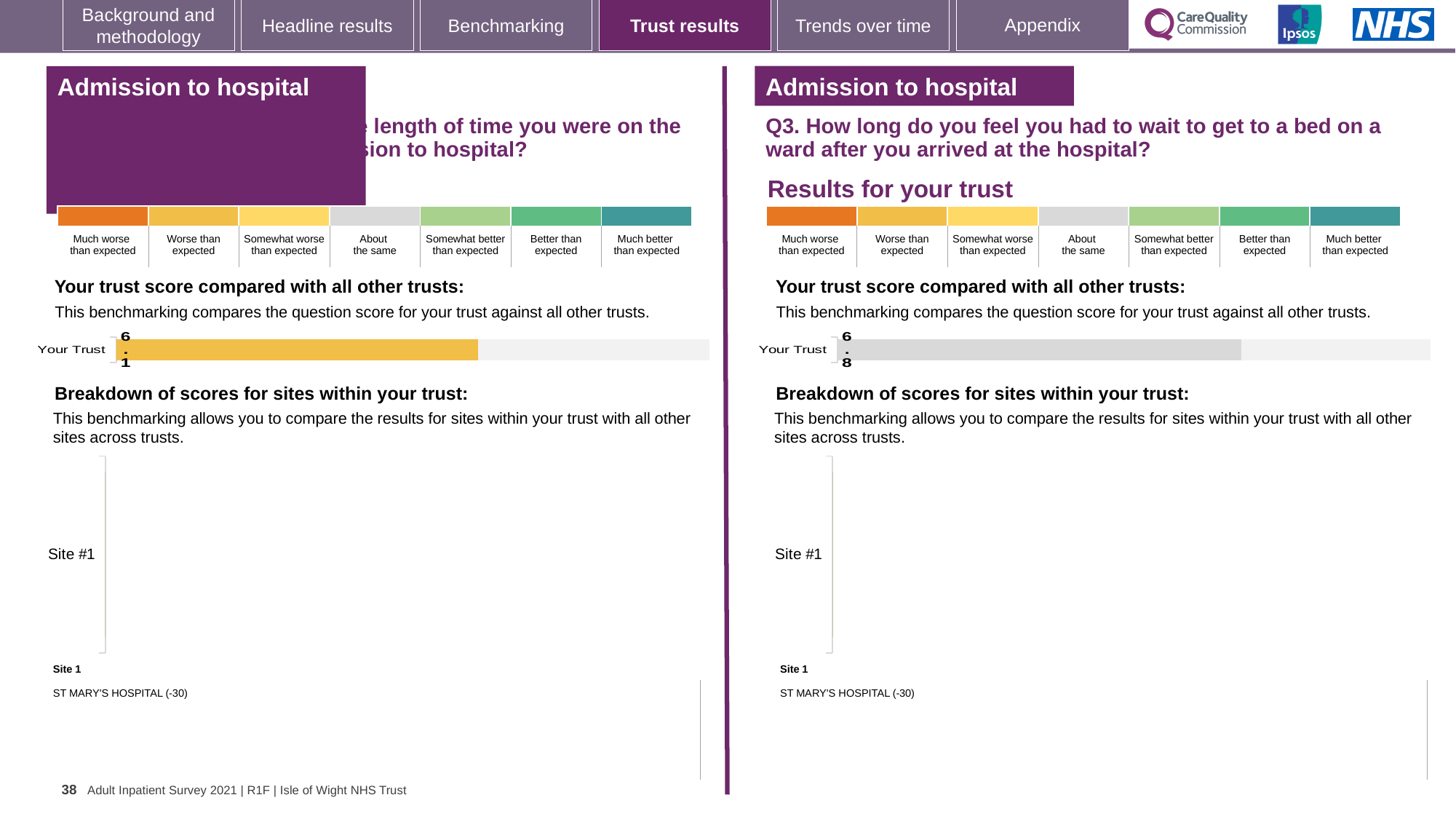
According to the colour key, which benchmark category does the grey colour of the Your Trust bar on the right-hand Q3 chart represent? About the same What is the label of the single bar in the right-hand Q3 trust score chart? Your Trust Which site is listed under 'Site 1' in the breakdown of scores for sites within your trust on the right-hand side? ST MARY'S HOSPITAL (-30) What kind of chart is used to show the Your Trust score on the left-hand side of the slide? Bar chart How many categories (bars) are plotted in the right-hand Q3 'Your trust score compared with all other trusts' chart? 1 How many benchmark categories are shown in the colour key above each chart? 7 On the left-hand 'Your trust score compared with all other trusts' chart, what is the score for Your Trust? 6.1 On the right-hand chart for Q3 (how long you had to wait to get to a bed on a ward), what is the score for Your Trust? 6.8 How many categories (bars) are plotted in the left-hand 'Your trust score compared with all other trusts' chart? 1 What is the difference between the Your Trust score on the right-hand Q3 chart and the Your Trust score on the left-hand chart? 0.7 Which trust score is higher: the left-hand chart's Your Trust score or the right-hand Q3 chart's Your Trust score? The right-hand Q3 chart (6.8)